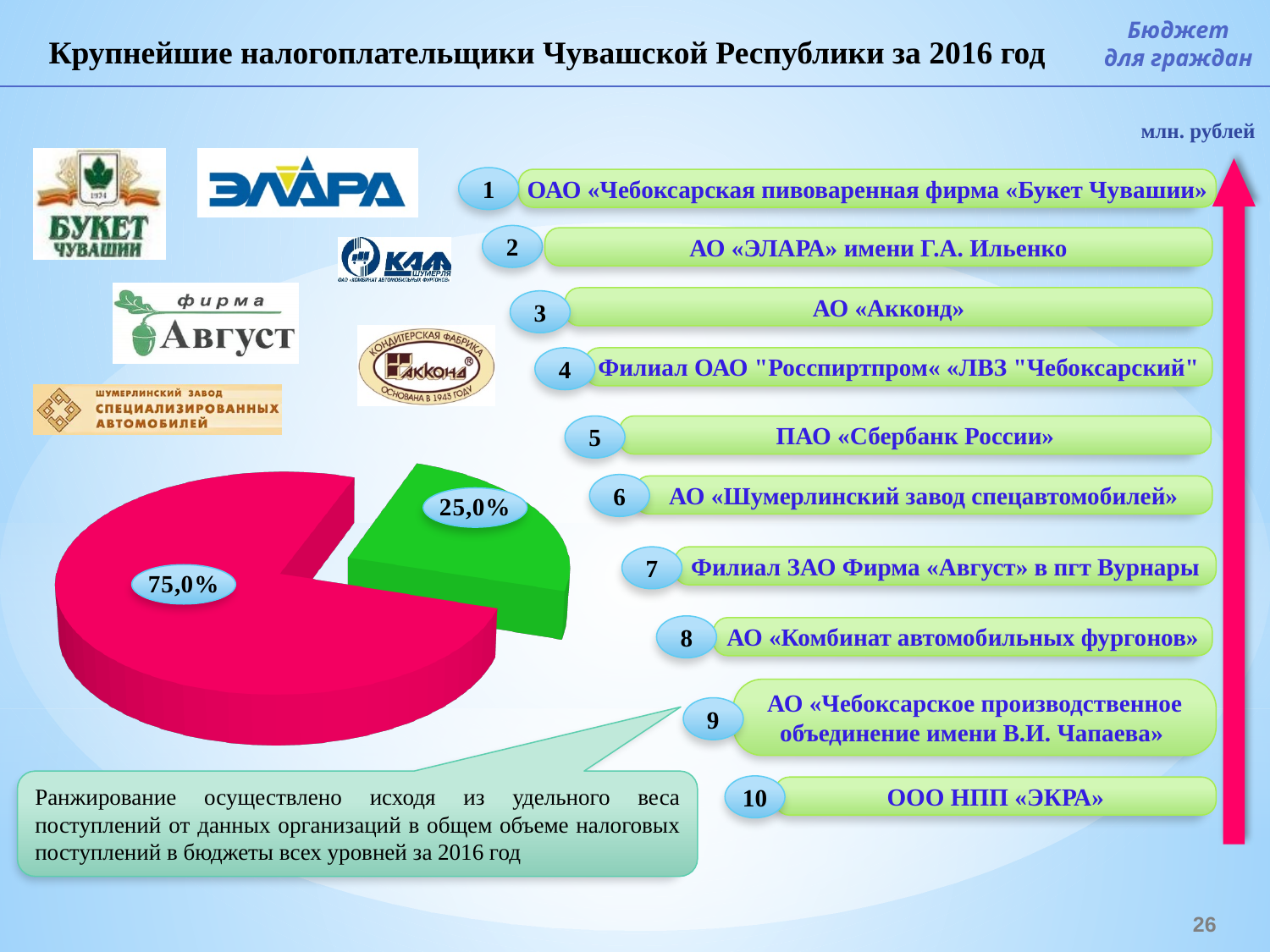
What is the difference between the two slices of the pie chart? 50,0% Is the largest slice of the pie chart greater or less than 50%? greater Is the smallest slice of the pie chart greater or less than 50%? less Which slice of the pie chart is pulled out from the rest? the green 25,0% slice What share of the pie does the green slice represent? 25,0% What kind of chart is shown on the slide? pie chart What is the value of the largest slice of the pie chart? 75,0% How many slices does the pie chart have? 2 Which slice is larger, the pink one or the green one? the pink one What do the two slices of the pie chart add up to? 100,0% What is the value of the smallest slice of the pie chart? 25,0%